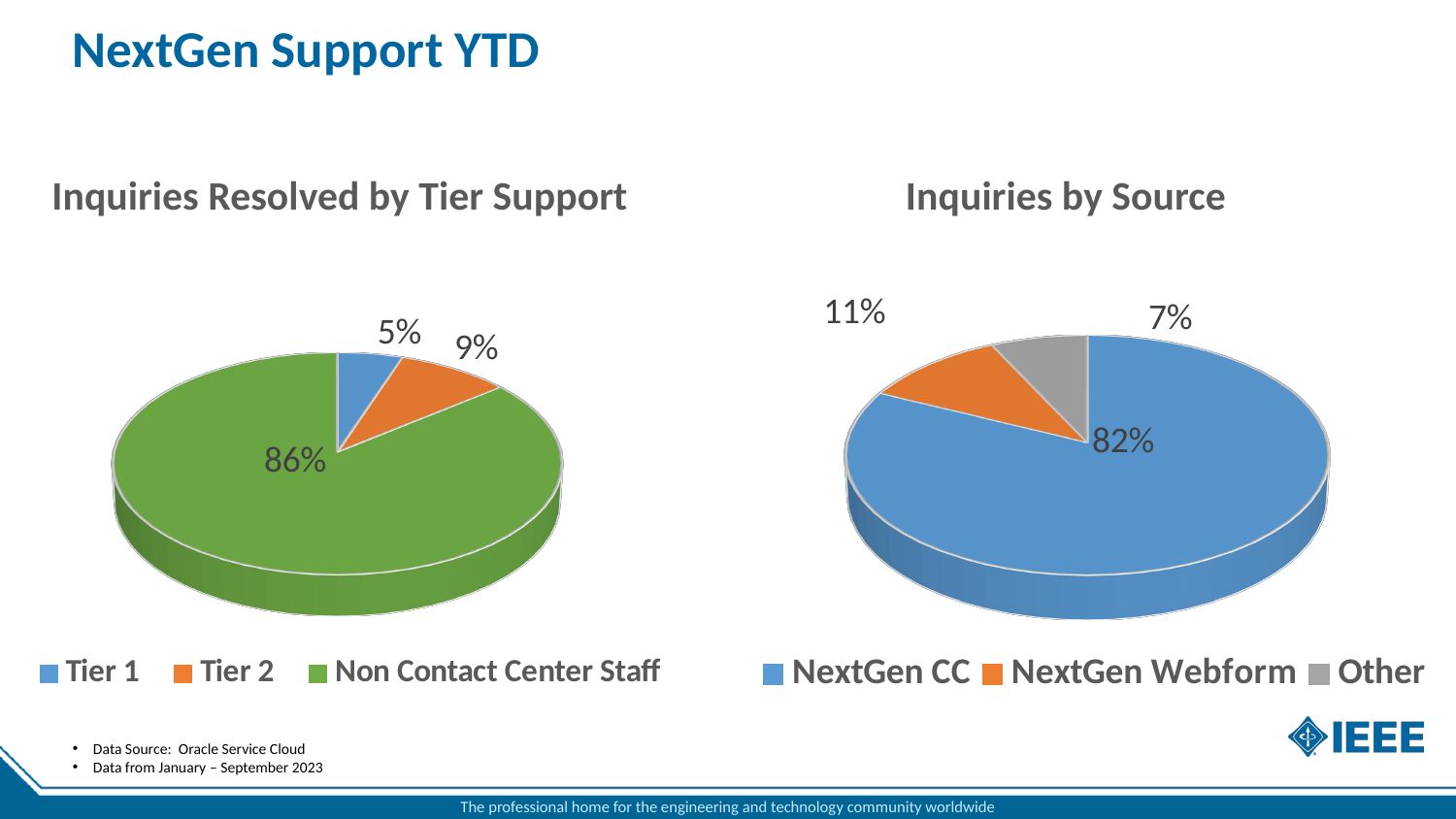
In the 'Inquiries Resolved by Tier Support' chart, how many categories are shown? 3 In the 'Inquiries by Source' chart, what is the difference between the NextGen CC and NextGen Webform shares? 71% In the 'Inquiries by Source' chart, which source has the largest slice? NextGen CC In the 'Inquiries Resolved by Tier Support' chart, what is the value for Tier 2? 9% In the 'Inquiries Resolved by Tier Support' chart, which category has the smallest slice? Tier 1 In the 'Inquiries by Source' chart, what is the value for Other? 7% In the 'Inquiries by Source' chart, what share of inquiries came from NextGen CC? 82% In the 'Inquiries by Source' chart, which is larger: NextGen Webform or Other? NextGen Webform In the 'Inquiries Resolved by Tier Support' chart, what colour is the Tier 2 slice? Orange In the 'Inquiries Resolved by Tier Support' chart, what is the difference between the Tier 2 and Tier 1 shares? 4% In the 'Inquiries Resolved by Tier Support' chart, what share of inquiries was resolved by Non Contact Center Staff? 86% What type of chart is the 'Inquiries by Source' chart? Pie chart